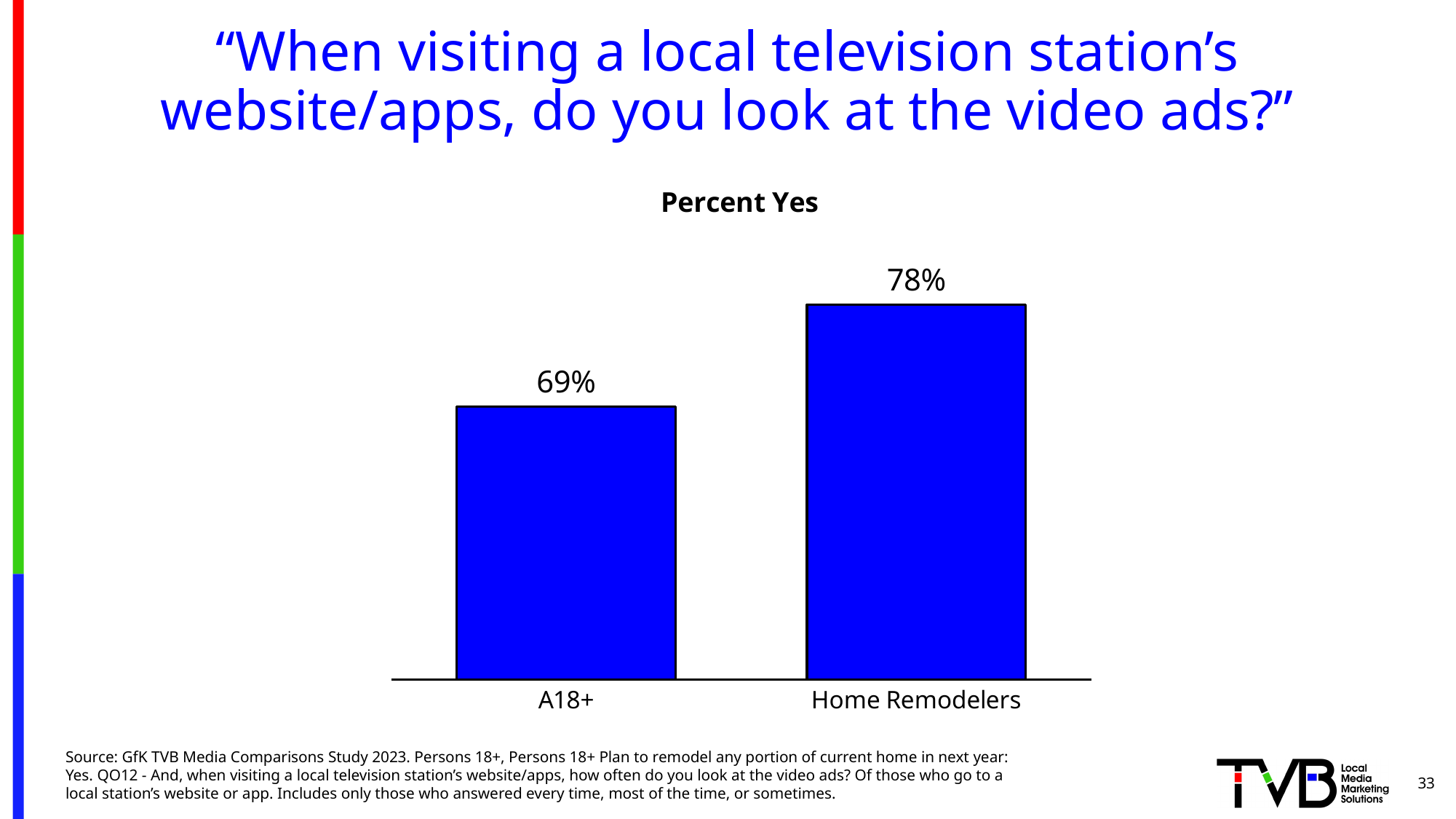
How many categories are shown in the chart? 2 What is the Percent Yes value for A18+? 69% What colour are the bars in the chart? Blue What is the difference in Percent Yes between Home Remodelers and A18+? 9% What kind of chart is shown on the slide? Bar chart Which is larger, the Percent Yes for A18+ or for Home Remodelers? Home Remodelers What is the Percent Yes value for Home Remodelers? 78% Which category has the highest Percent Yes value? Home Remodelers Do the values rise or fall from A18+ to Home Remodelers? Rise What is the title of the chart? Percent Yes Which category has the lowest Percent Yes value? A18+